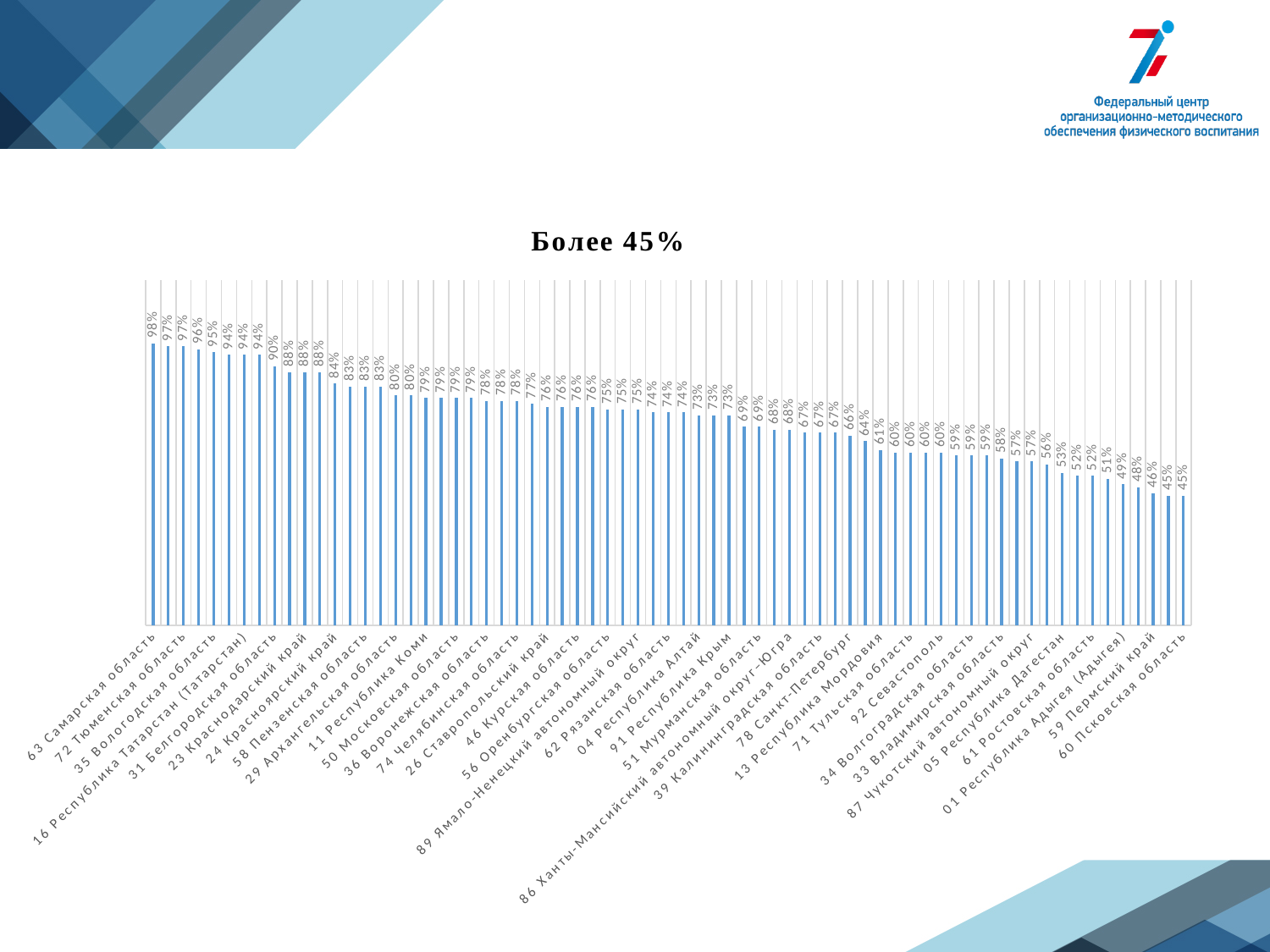
What is the difference between the values for 63 Самарская область and 60 Псковская область? 53 percentage points What is the lowest value shown in the chart? 45% What is the value for 60 Псковская область? 45% What is the highest value shown in the chart? 98% Which is larger, the value for 63 Самарская область or the value for 59 Пермский край? 63 Самарская область What kind of chart is shown on the slide? bar chart What is the value for 63 Самарская область? 98% Do the values rise or fall from left to right along the x axis? fall What is the title of the chart? Более 45% What is the value for 59 Пермский край? 46% What is the value for 72 Тюменская область? 97% Which region has the highest value in the chart? 63 Самарская область